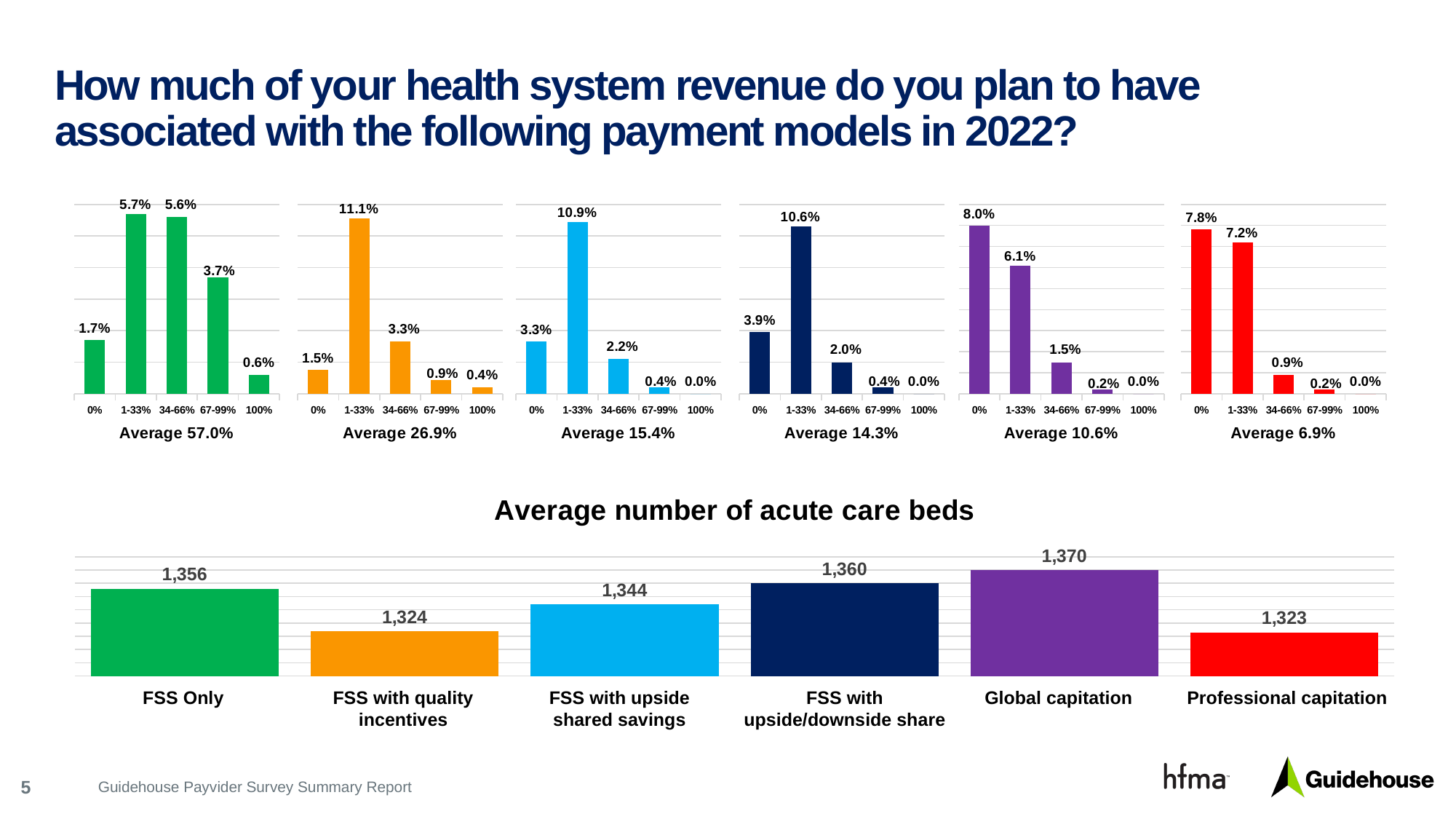
What type of chart is the 'Average number of acute care beds' chart? bar chart In the 'Average number of acute care beds' chart, which is larger: FSS with upside shared savings or FSS with upside/downside share? FSS with upside/downside share In the 'Average number of acute care beds' chart, how many categories are shown? 6 In the top-left chart labelled 'Average 57.0%', what is the value for the 1-33% category? 5.7% In the top chart labelled 'Average 10.6%', what is the difference between the 0% and 1-33% categories? 1.9% In the top chart labelled 'Average 26.9%', which category has the highest value? 1-33% In the 'Average number of acute care beds' chart, which category has the highest value? Global capitation In the 'Average number of acute care beds' chart, what is the value for Global capitation? 1,370 In the 'Average number of acute care beds' chart, what is the difference between FSS Only and FSS with quality incentives? 32 In the 'Average number of acute care beds' chart, which category has the lowest value? Professional capitation In the top chart labelled 'Average 6.9%', do the values rise or fall moving from the 0% category to the 100% category? fall In the top chart labelled 'Average 15.4%', what is the value for the 0% category? 3.3%